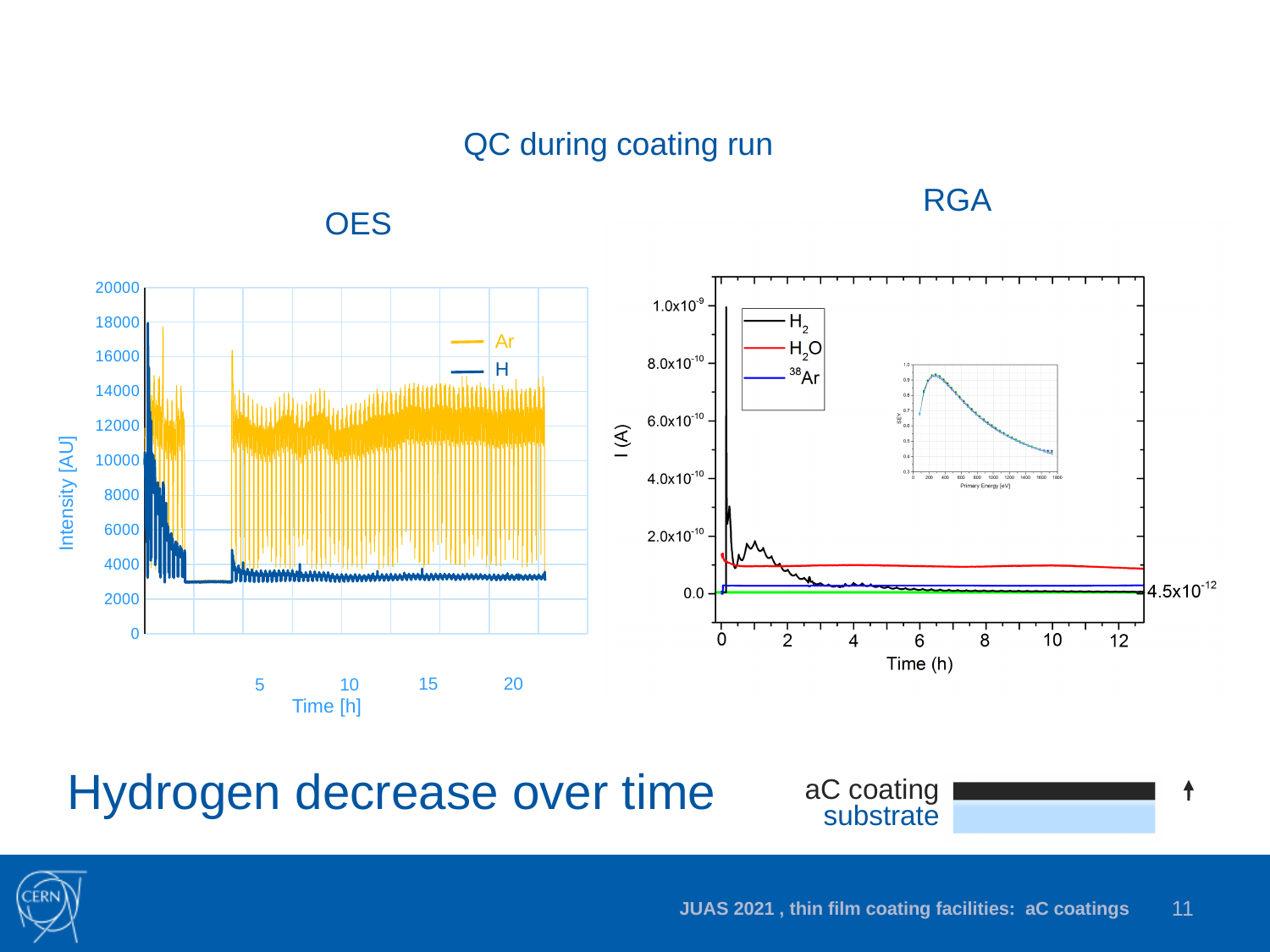
How many series does the legend of the OES chart list? 2 In the RGA chart, does the H2 current rise or fall over time? fall How many series does the legend of the RGA chart list? 3 In the OES chart, which series has the higher intensity at 20 h, Ar or H? Ar What type of chart is the OES chart on the left? line chart In the RGA chart, which series has the highest current at the start of the run (near 0 h)? H2 In the OES chart, does the H intensity rise or fall over the first 5 hours? fall In the OES chart, is the Ar intensity at 15 h greater or less than 8000? greater In the OES chart, which series is shown in yellow? Ar In the OES chart, what is the label of the y axis? Intensity [AU] In the RGA chart, which series has the larger current at 6 h, H2O or 38Ar? H2O In the OES chart, is the H intensity at 15 h greater or less than 6000? less